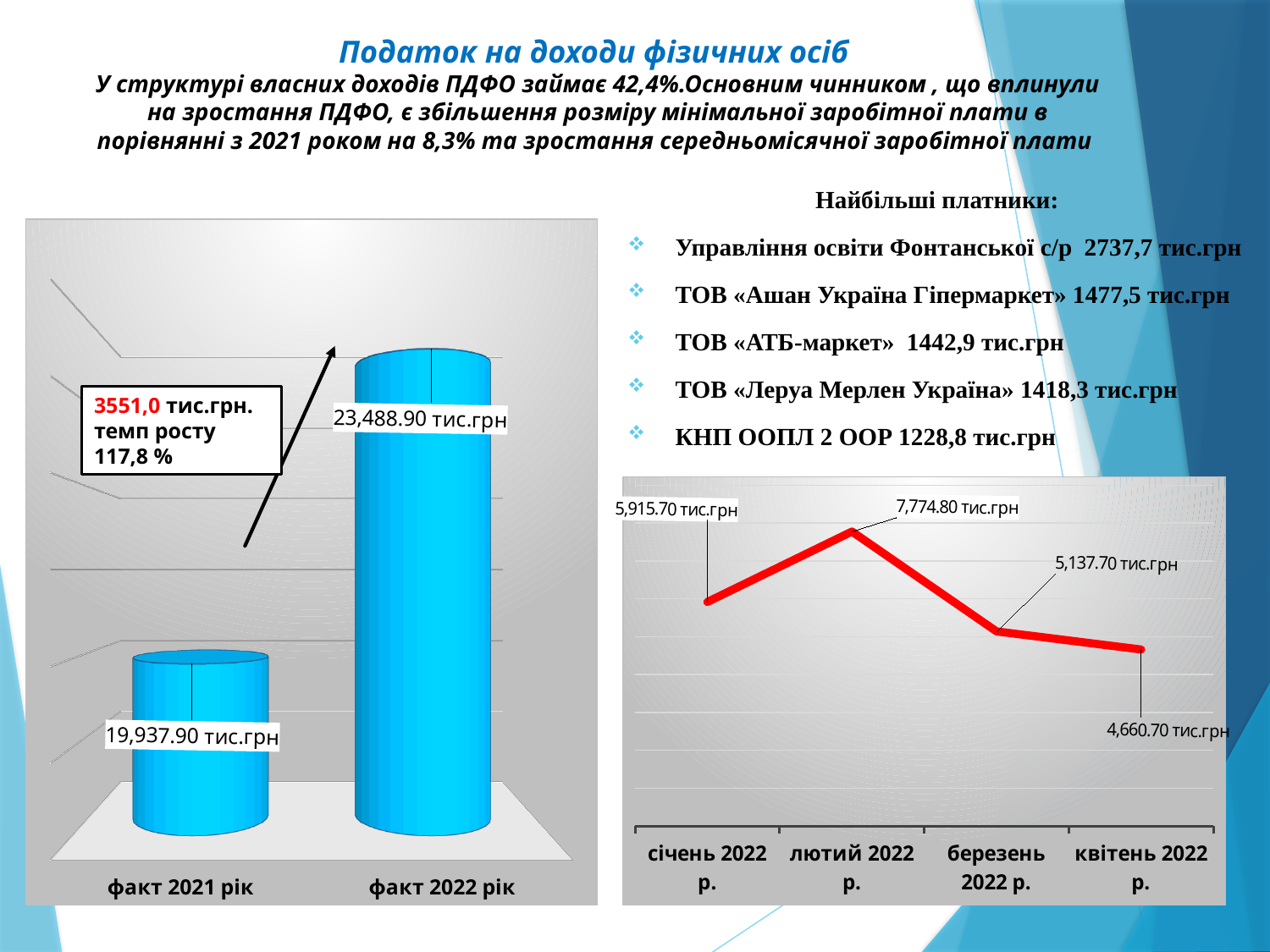
On the right line chart, how many data points are plotted? 4 On the right line chart, what is the value for лютий 2022 р.? 7,774.80 тис.грн On the left bar chart, what is the value for факт 2021 рік? 19,937.90 тис.грн On the right line chart, which month has the highest value? лютий 2022 р. On the left bar chart, what growth rate (темп росту) is shown in the annotation box? 117,8 % On the left bar chart, what is the difference between the values for факт 2022 рік and факт 2021 рік? 3,551.00 тис.грн On the right line chart, what is the difference between the values for лютий 2022 р. and січень 2022 р.? 1,859.10 тис.грн On the right line chart, which month has the lowest value? квітень 2022 р. On the right line chart, what is the value for квітень 2022 р.? 4,660.70 тис.грн What kind of chart is the chart on the left of the slide? bar chart On the right line chart, do the values rise or fall from лютий 2022 р. to квітень 2022 р.? fall On the left bar chart, what is the value for факт 2022 рік? 23,488.90 тис.грн